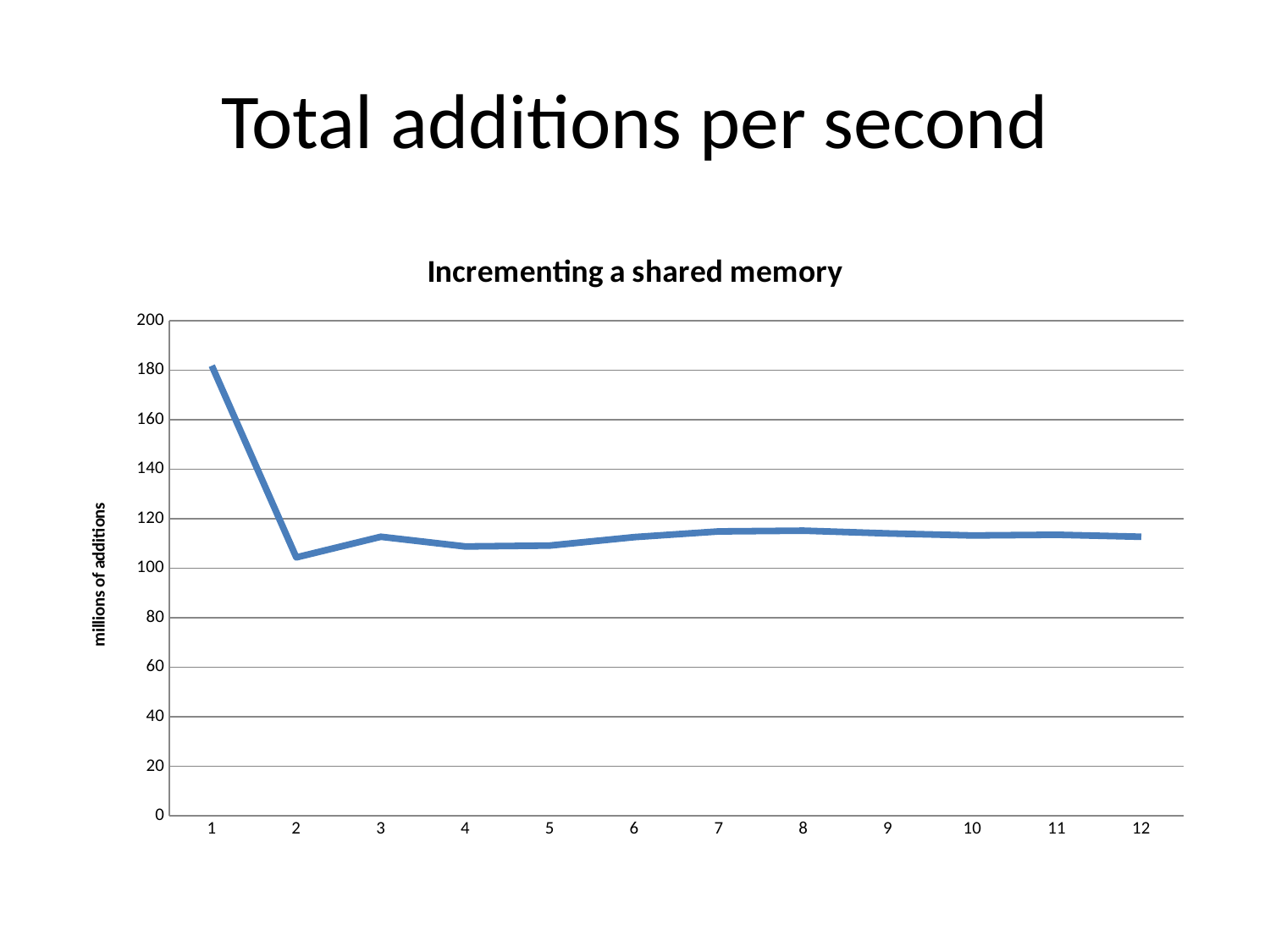
Is the value at x = 12 greater or less than 140? less Is the value at x = 2 greater or less than 120? less How many data points are plotted on the line? 12 Which x-axis category has the highest value? 1 Which has the larger value, x = 1 or x = 2? 1 Which x-axis category has the lowest value? 2 Is the value at x = 7 greater or less than 100? greater What is the label on the vertical axis of the chart? millions of additions What kind of chart is shown on the slide? line chart What is the title of the chart? Incrementing a shared memory Does the line rise or fall from x = 1 to x = 2? fall